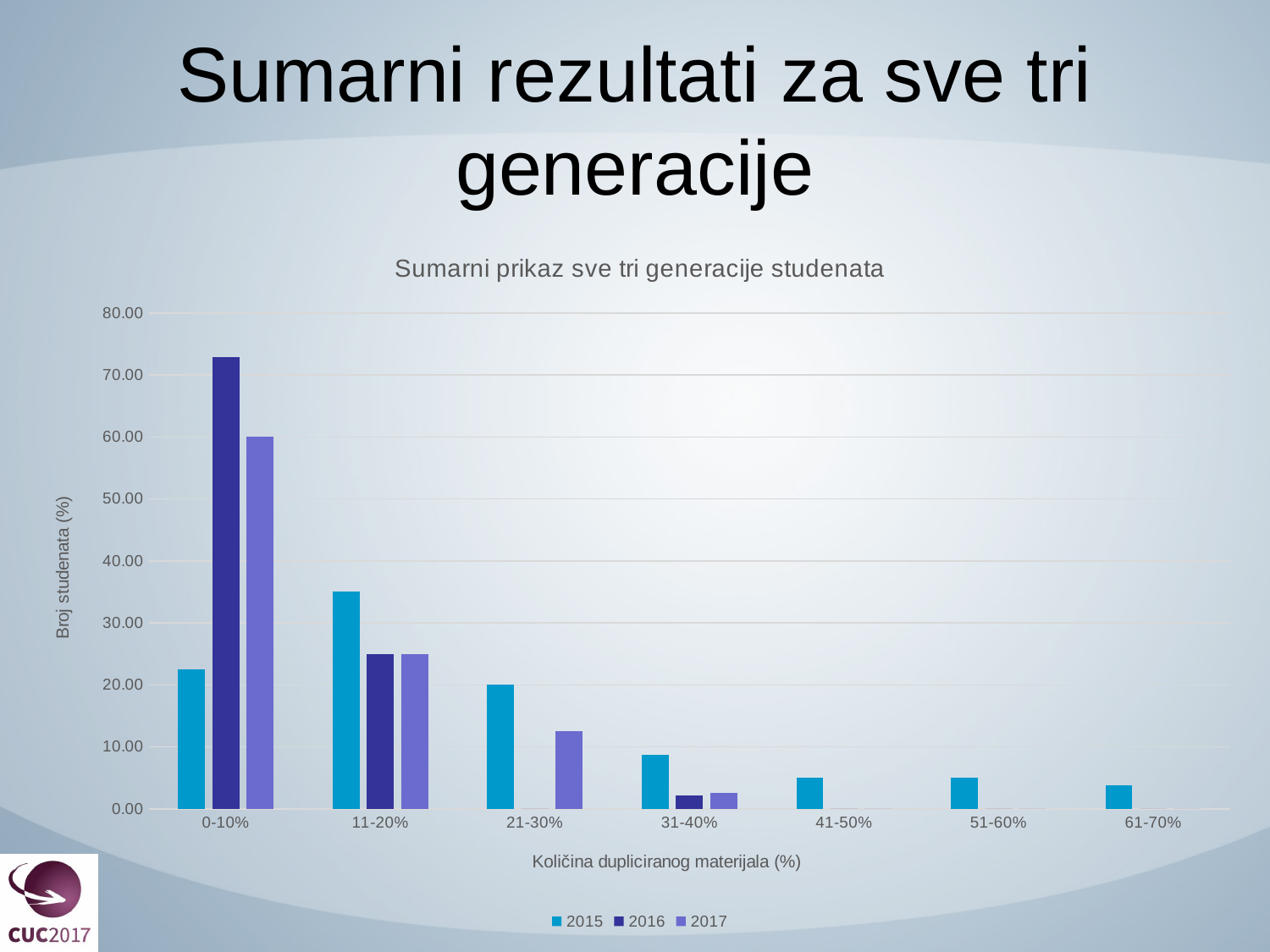
Which is larger in the 21-30% category, the value for 2015 or the value for 2017? 2015 What is the title of the chart? Sumarni prikaz sve tri generacije studenata Which series has the highest bar in the 0-10% category? 2016 How many categories are shown on the x axis? 7 Is the value for 2015 in the 11-20% category greater or less than 30.00? greater Is the value for 2017 in the 0-10% category greater or less than 50.00? greater Do the values for the 2016 series rise or fall from the 0-10% category to the 31-40% category? fall In which category does the 2015 series reach its highest value? 11-20% Is the value for 2015 in the 31-40% category greater or less than 10.00? less How many series does the legend list? 3 What kind of chart is shown on the slide? bar chart